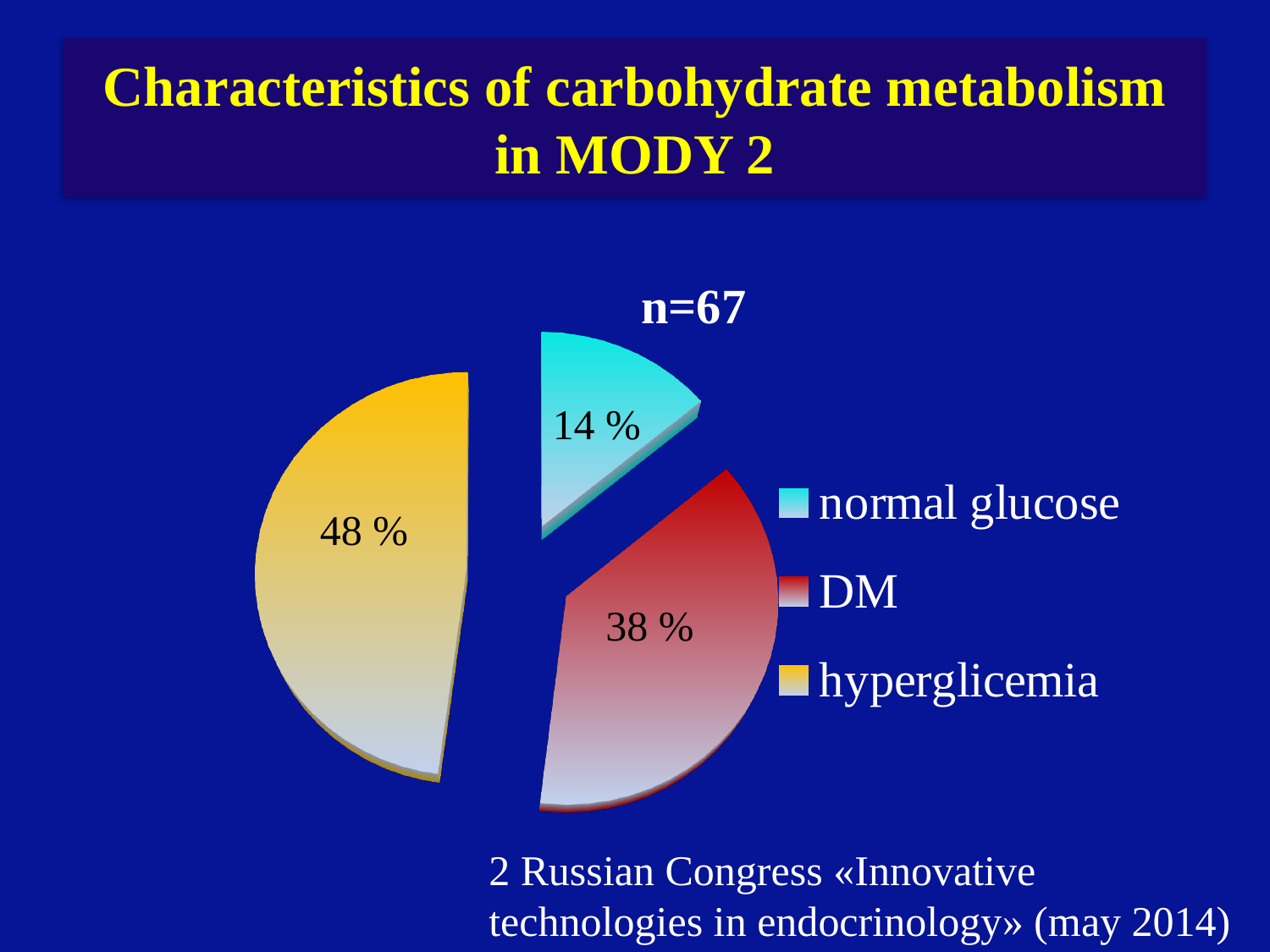
What percentage of the pie is labelled for DM? 38 % How many slices does the pie chart have? 3 Which category has the smallest slice of the pie? normal glucose What kind of chart is shown on the slide? pie chart What percentage of the pie is labelled for normal glucose? 14 % What percentage of the pie is labelled for hyperglicemia? 48 % Which slice is larger, DM or normal glucose? DM What sample size is shown above the pie chart? n=67 How many entries does the legend list? 3 What is the difference in percentage points between the hyperglicemia slice and the DM slice? 10 What colour is the slice for normal glucose? cyan Which category has the largest slice of the pie? hyperglicemia